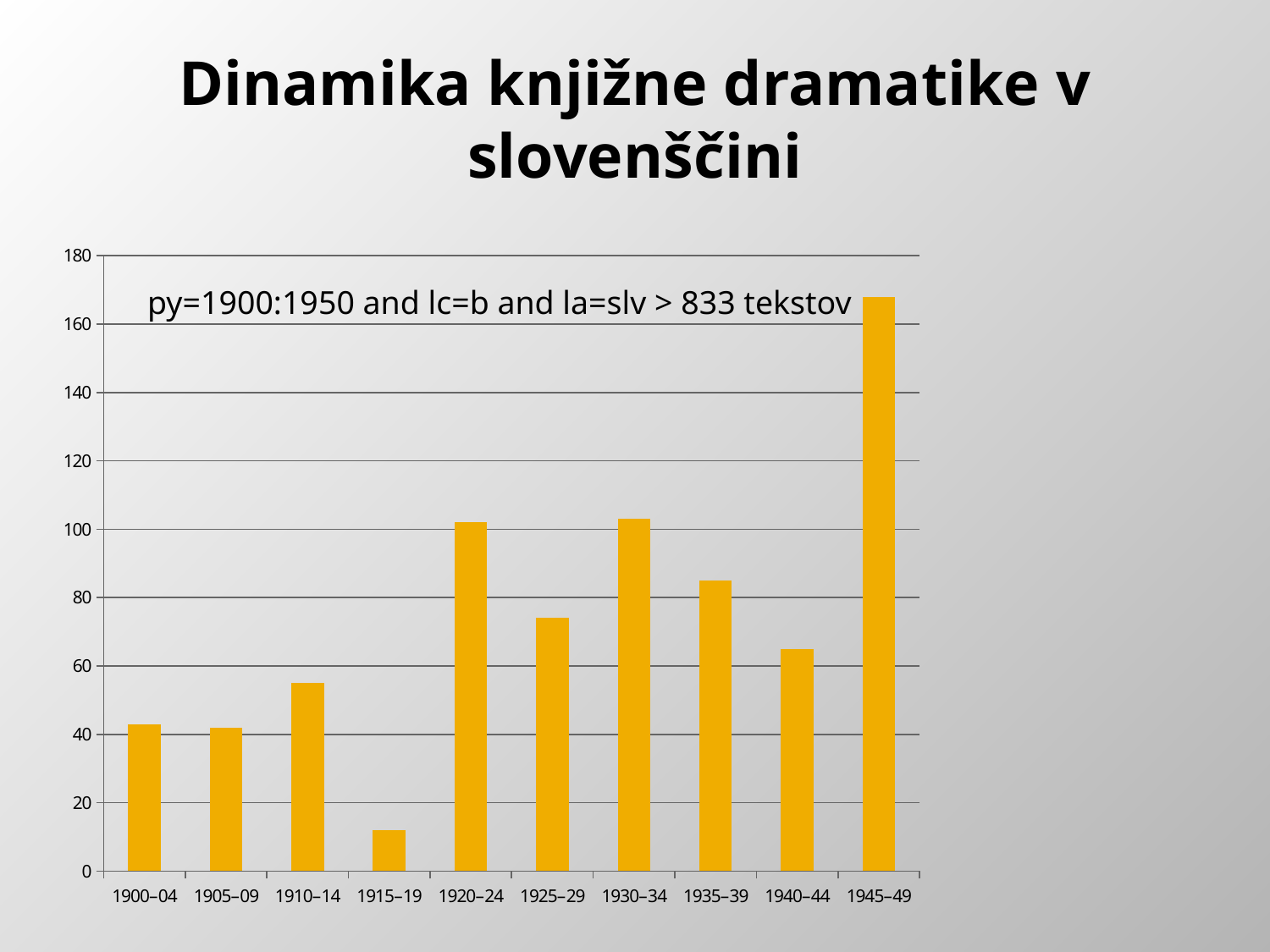
Is the value for 1945–49 greater or less than 160? greater Is the value for 1915–19 greater or less than 20? less Is the value for 1940–44 greater or less than 60? greater Which has the larger value, 1910–14 or 1940–44? 1940–44 Which has the larger value, 1935–39 or 1925–29? 1935–39 Which period has the highest value? 1945–49 How many five-year periods are shown on the x axis? 10 According to the text inside the chart, how many texts does the query return? 833 tekstov What kind of chart is shown on the slide? bar chart Do the values rise or fall from 1930–34 to 1940–44? fall Which period has the lowest value? 1915–19